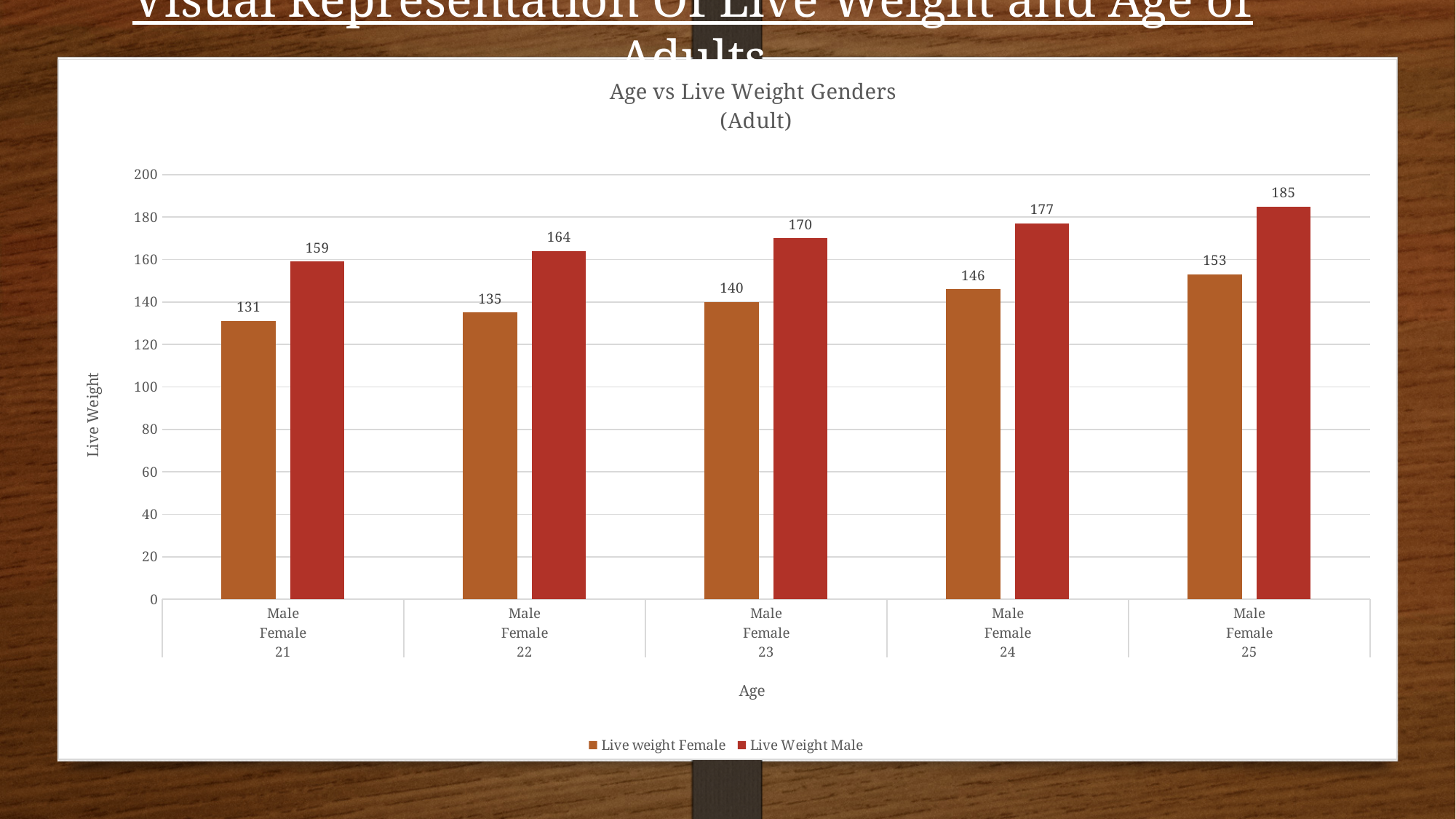
At which age is the Live weight Female value lowest? 21 Do the Live Weight Male values rise or fall as age increases from 21 to 25? rise What is the Live Weight Male value at age 23? 170 How many series does the legend list? 2 Is the Live weight Female value at age 25 greater or less than 140? greater What kind of chart is shown? bar chart What is the Live weight Female value at age 21? 131 What is the difference between the Live Weight Male and Live weight Female values at age 24? 31 At which age is the Live Weight Male value highest? 25 Which is larger at age 22: Live weight Female or Live Weight Male? Live Weight Male What is the Live Weight Male value at age 25? 185 How many age categories are shown on the x axis? 5